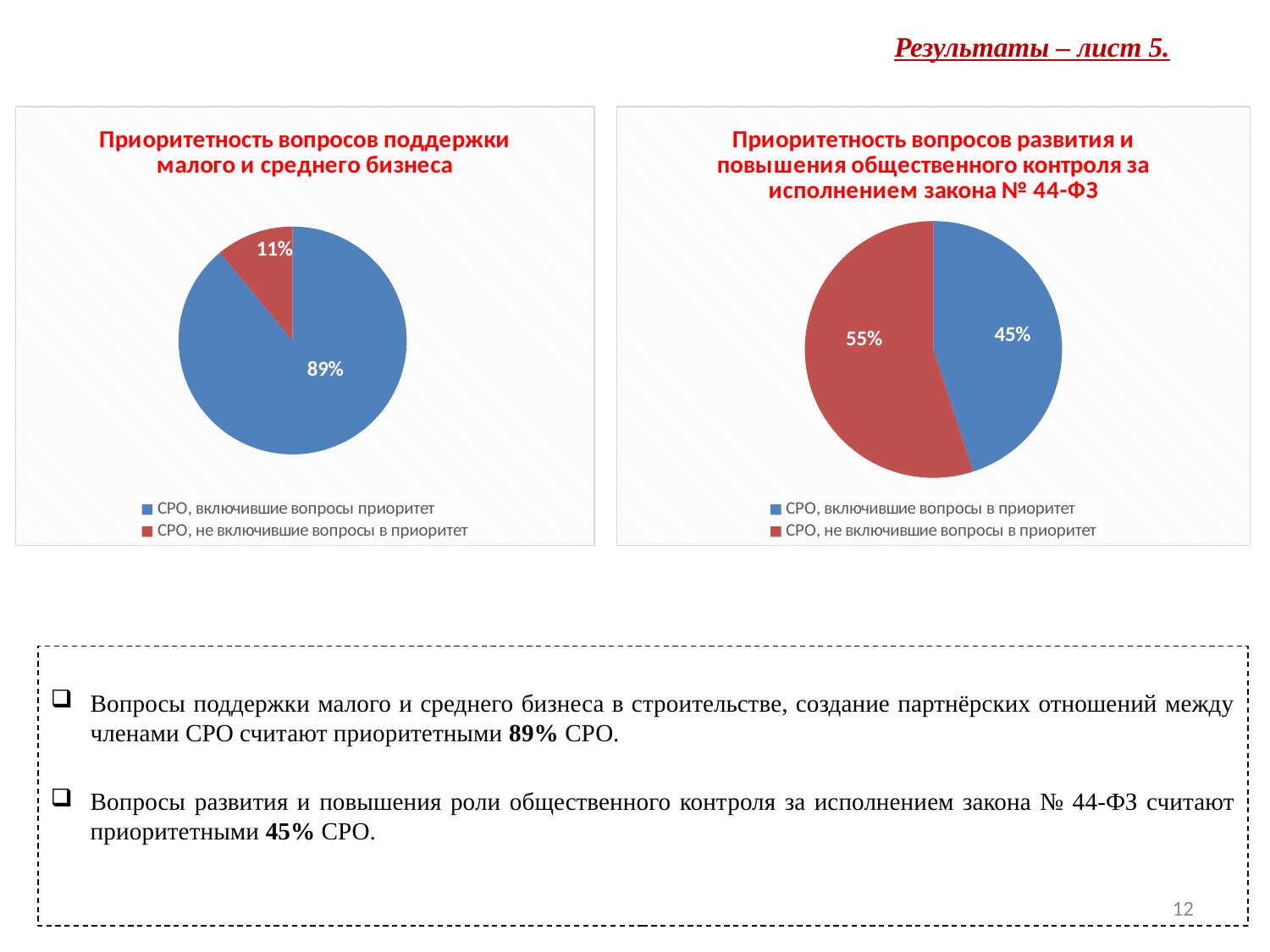
In the left chart, what is the difference in percentage points between the two slices? 78 In the right chart, which is larger: the slice for СРО, включившие вопросы в приоритет or the slice for СРО, не включившие вопросы в приоритет? СРО, не включившие вопросы в приоритет In the left chart, what colour is the slice for СРО, не включившие вопросы в приоритет? Red In the left chart (Приоритетность вопросов поддержки малого и среднего бизнеса), what share of the pie is labelled for СРО, включившие вопросы приоритет? 89% What type of chart is the left chart? Pie chart In the right chart, which category has the smallest slice? СРО, включившие вопросы в приоритет In the left chart, which category has the largest slice? СРО, включившие вопросы приоритет In the left chart (Приоритетность вопросов поддержки малого и среднего бизнеса), what share of the pie is labelled for СРО, не включившие вопросы в приоритет? 11% In the right chart, what is the difference in percentage points between the two slices? 10 In the right chart (Приоритетность вопросов развития и повышения общественного контроля за исполнением закона № 44-ФЗ), what share is labelled for СРО, не включившие вопросы в приоритет? 55% How many slices does the right chart have? 2 In the right chart (Приоритетность вопросов развития и повышения общественного контроля за исполнением закона № 44-ФЗ), what share is labelled for СРО, включившие вопросы в приоритет? 45%